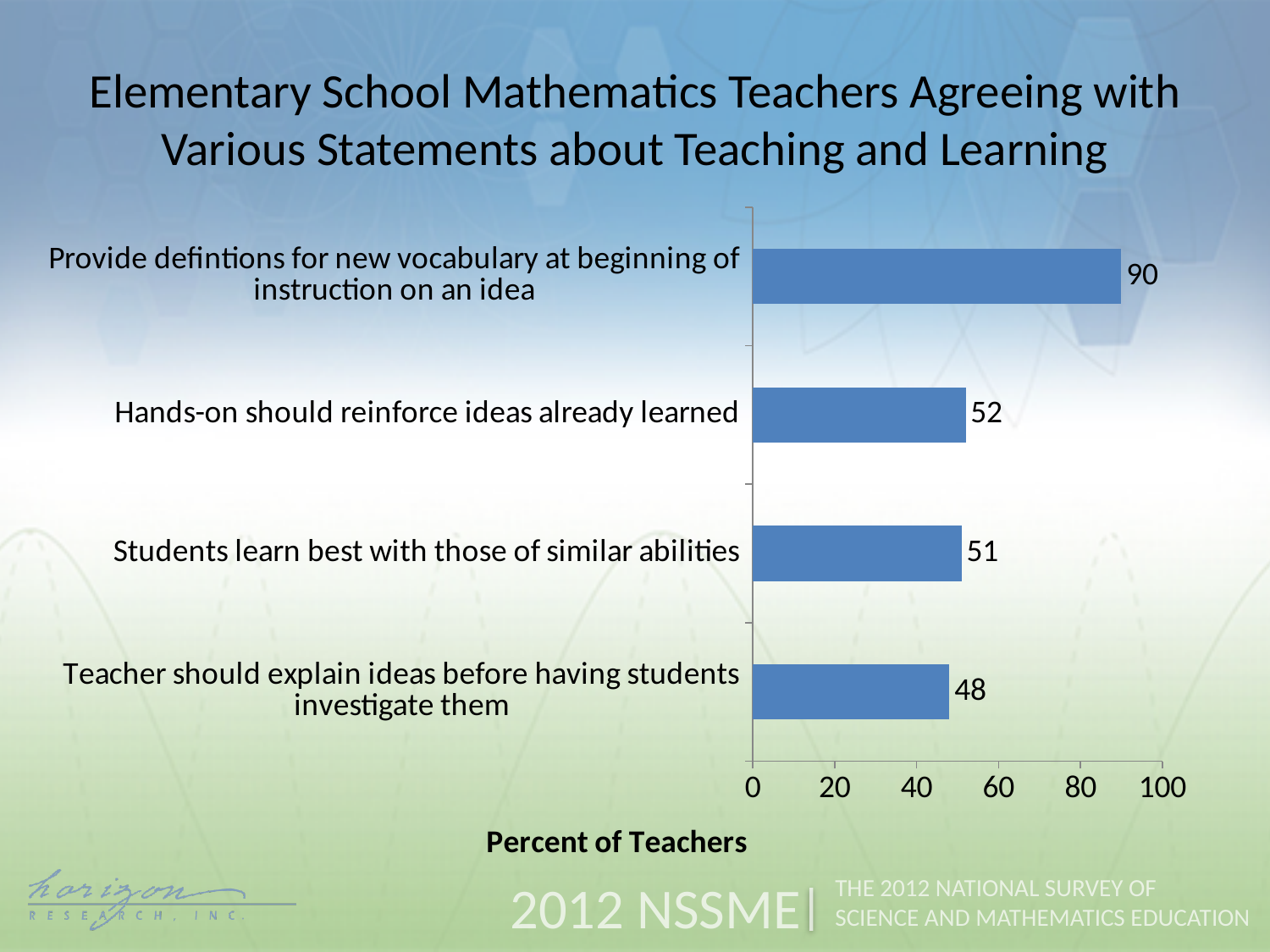
Which statement had the lowest percent of teachers agreeing? Teacher should explain ideas before having students investigate them What percent of teachers agreed with "Teacher should explain ideas before having students investigate them"? 48 What percent of teachers agreed with "Students learn best with those of similar abilities"? 51 Which statement had the highest percent of teachers agreeing? Provide defintions for new vocabulary at beginning of instruction on an idea What percent of teachers agreed with "Provide defintions for new vocabulary at beginning of instruction on an idea"? 90 What percent of teachers agreed with "Hands-on should reinforce ideas already learned"? 52 What is the difference in percent of teachers between "Hands-on should reinforce ideas already learned" and "Students learn best with those of similar abilities"? 1 How many statements are shown in the chart? 4 What kind of chart is shown on the slide? Bar chart What is the difference in percent of teachers between "Provide defintions for new vocabulary at beginning of instruction on an idea" and "Teacher should explain ideas before having students investigate them"? 42 Which had a higher percent of teachers agreeing: "Hands-on should reinforce ideas already learned" or "Teacher should explain ideas before having students investigate them"? Hands-on should reinforce ideas already learned What is the label of the horizontal axis? Percent of Teachers